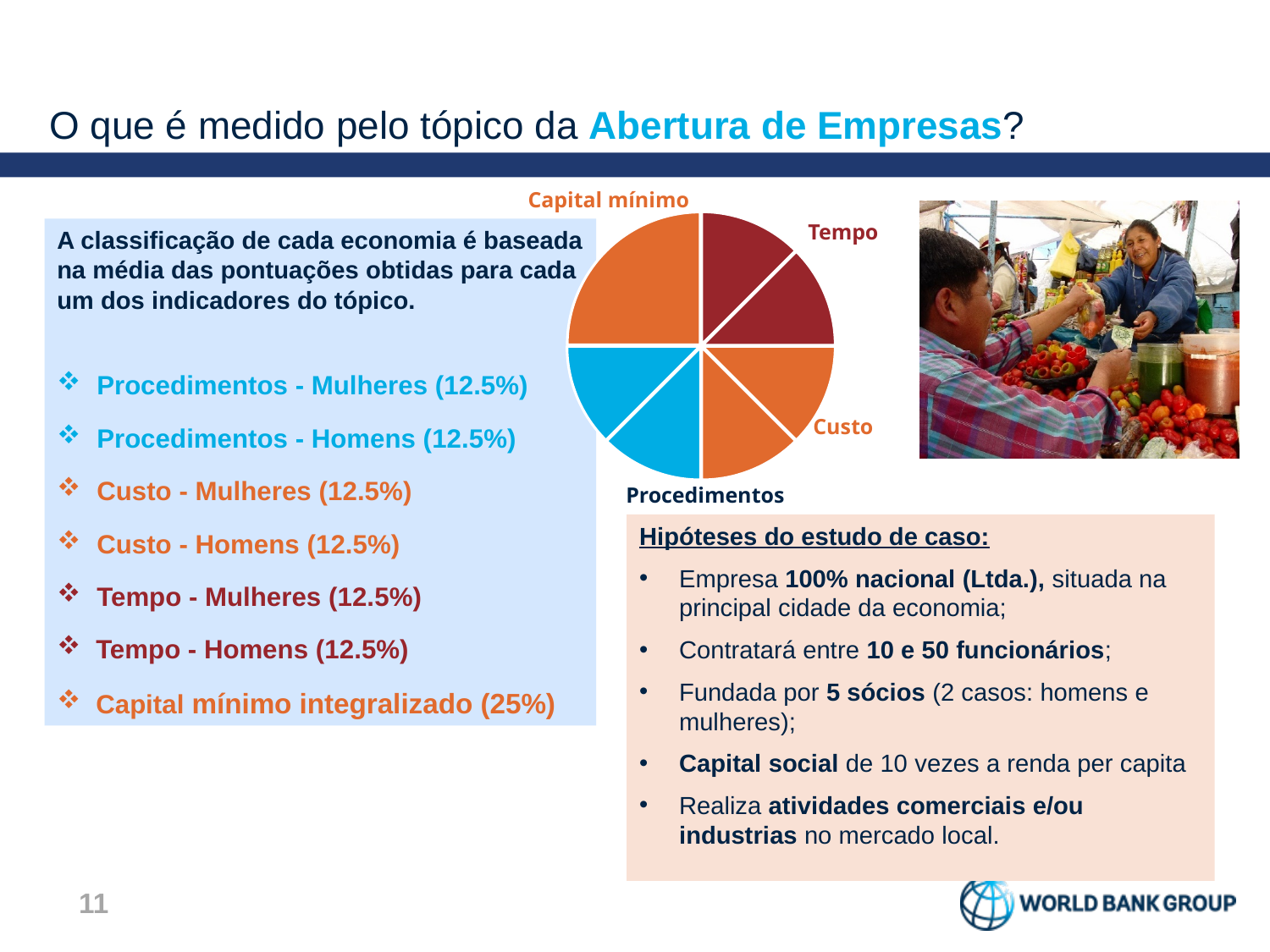
Which is larger in the pie chart: the Capital mínimo slice or a single Tempo slice? Capital mínimo How many slices does the pie chart have? 7 What colour are the Procedimentos slices in the pie chart? blue What kind of chart is shown on the slide? pie chart Which labels appear around the pie chart? Capital mínimo, Tempo, Custo, Procedimentos What share of the pie does the Capital mínimo slice represent? 25% What colour are the Tempo slices in the pie chart? dark red How many category labels are shown around the pie chart? 4 What share of the pie does each Tempo slice represent? 12.5% Which labelled slice of the pie chart is the largest? Capital mínimo